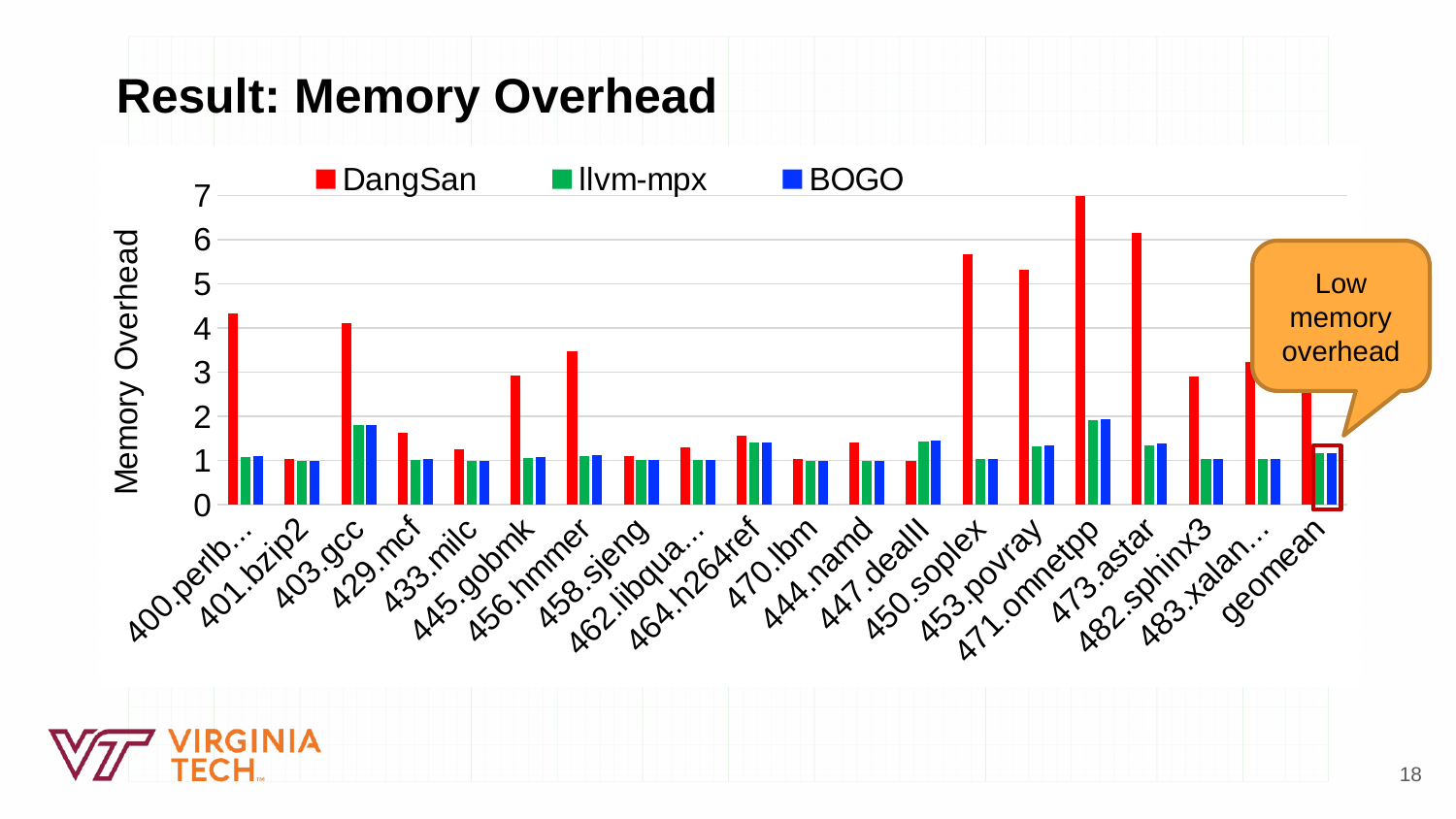
For 456.hmmer, which is larger: the DangSan value or the BOGO value? DangSan Is the BOGO value for 403.gcc greater or less than 2? less What is the label on the y axis? Memory Overhead Which category has the highest DangSan memory overhead? 471.omnetpp How many benchmark categories are shown along the x axis (including geomean)? 20 Is the DangSan value for 450.soplex greater or less than 5? greater Is the DangSan value for 445.gobmk greater or less than 2? greater What does the callout pointing at the geomean bars say? Low memory overhead How many series does the legend list? 3 What kind of chart is shown on the slide? bar chart